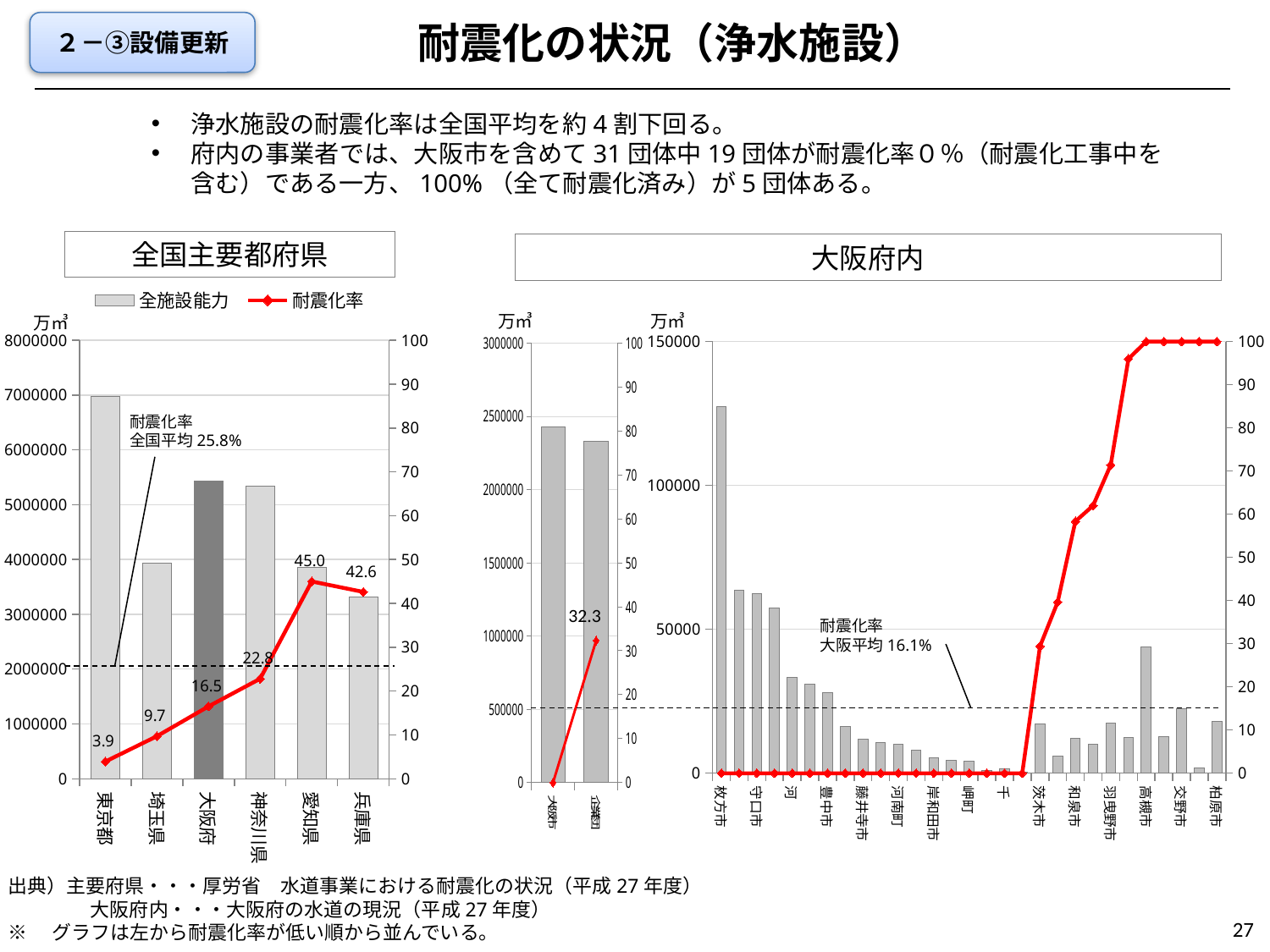
In the 全国主要都府県 chart, what is the 耐震化率 value for 大阪府? 16.5 In the 全国主要都府県 chart, what is the 耐震化率 value for 東京都? 3.9 In the 全国主要都府県 chart, which prefecture has the highest 耐震化率? 愛知県 How many series does the legend of the 全国主要都府県 chart list? 2 In the 全国主要都府県 chart, which has the larger 全施設能力 bar, 東京都 or 埼玉県? 東京都 In the 大阪府内 chart on the right, is the 全施設能力 bar for 枚方市 greater or less than 100000? greater In the 全国主要都府県 chart, what is the difference between the 耐震化率 of 愛知県 and 兵庫県? 2.4 How many prefectures are shown on the x axis of the 全国主要都府県 chart? 6 In the 全国主要都府県 chart, what is the 耐震化率 value for 愛知県? 45.0 In the 全国主要都府県 chart, is the 全施設能力 value for 東京都 greater or less than 6000000? greater In the 大阪府内 chart on the right, does the 耐震化率 line rise or fall from left to right? rise In the 全国主要都府県 chart, which prefecture has the lowest 耐震化率? 東京都